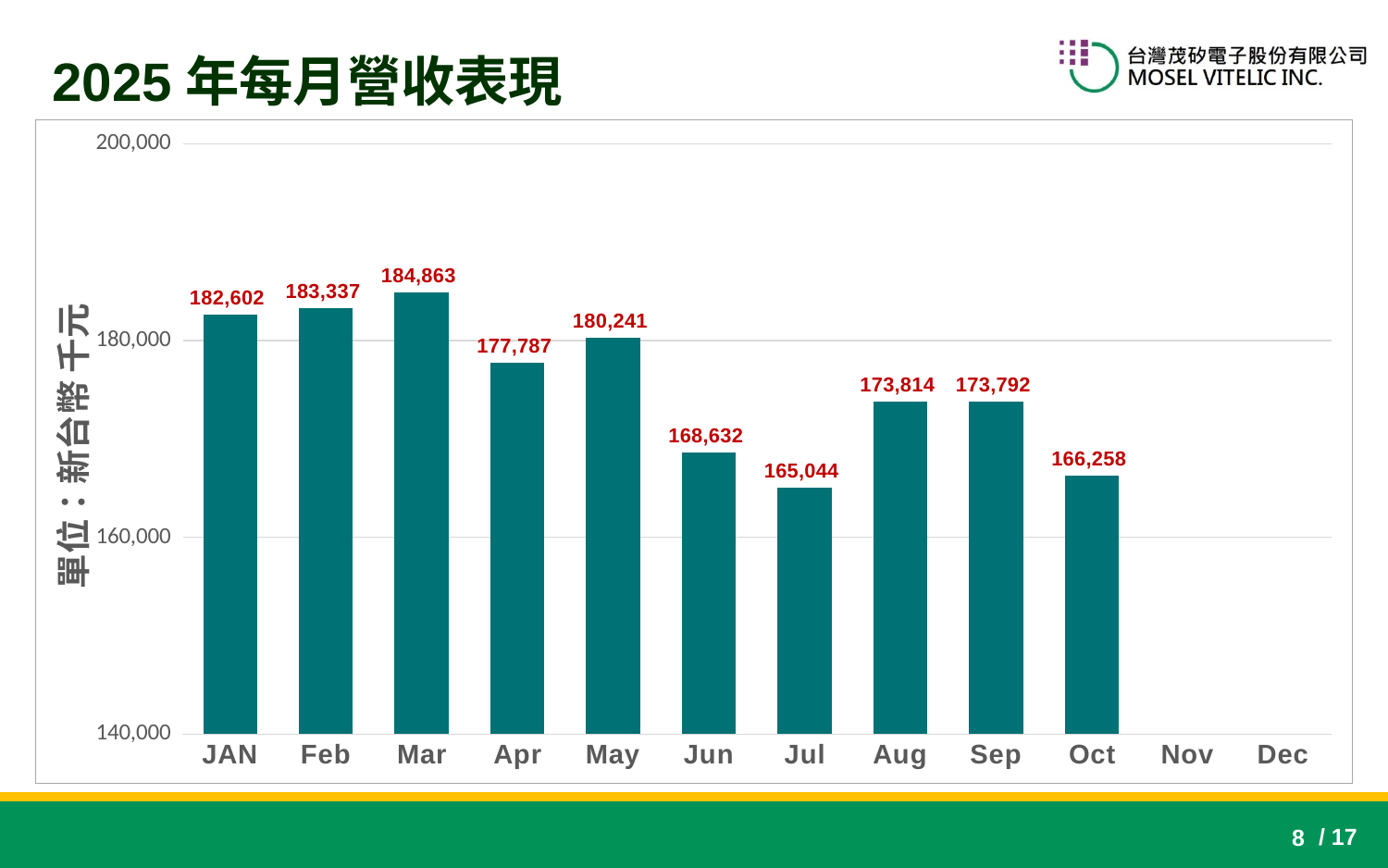
Which is larger, the value for May or the value for Apr? May Which month has the highest revenue bar? Mar Do the values rise or fall from Mar to Jul? fall Is the value for Jul greater or less than 160,000? greater Which month has the lowest revenue bar among the plotted months? Jul What is the revenue value shown for Oct? 166,258 What kind of chart is shown on the slide? bar chart What is the difference between the Feb value and the JAN value? 735 What is the difference between the Mar value and the Jul value? 19,819 How many months have a bar plotted on the chart? 10 What is the revenue value shown for Mar? 184,863 What is the revenue value shown for Jul? 165,044